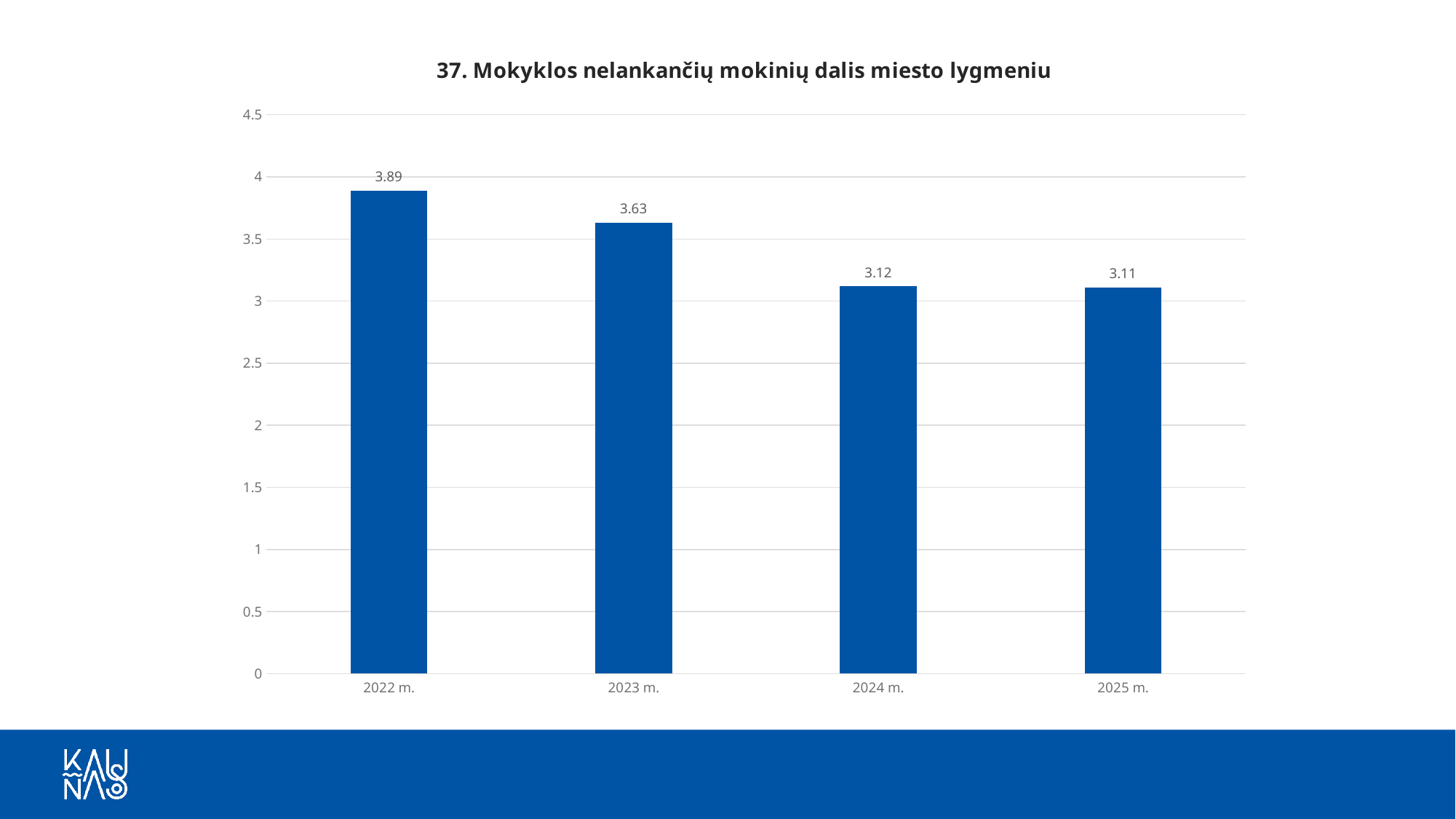
What is the value for 2025 m.? 3.11 Which year has the lowest value? 2025 m. Do the values rise or fall from 2022 m. to 2025 m.? Fall Which is larger, the value for 2023 m. or the value for 2024 m.? 2023 m. How many years are shown on the x axis? 4 What is the value for 2022 m.? 3.89 Which year has the highest value? 2022 m. What kind of chart is this? Bar chart What is the difference between the values for 2022 m. and 2025 m.? 0.78 What is the value for 2023 m.? 3.63 What is the value for 2024 m.? 3.12 What is the difference between the values for 2022 m. and 2023 m.? 0.26